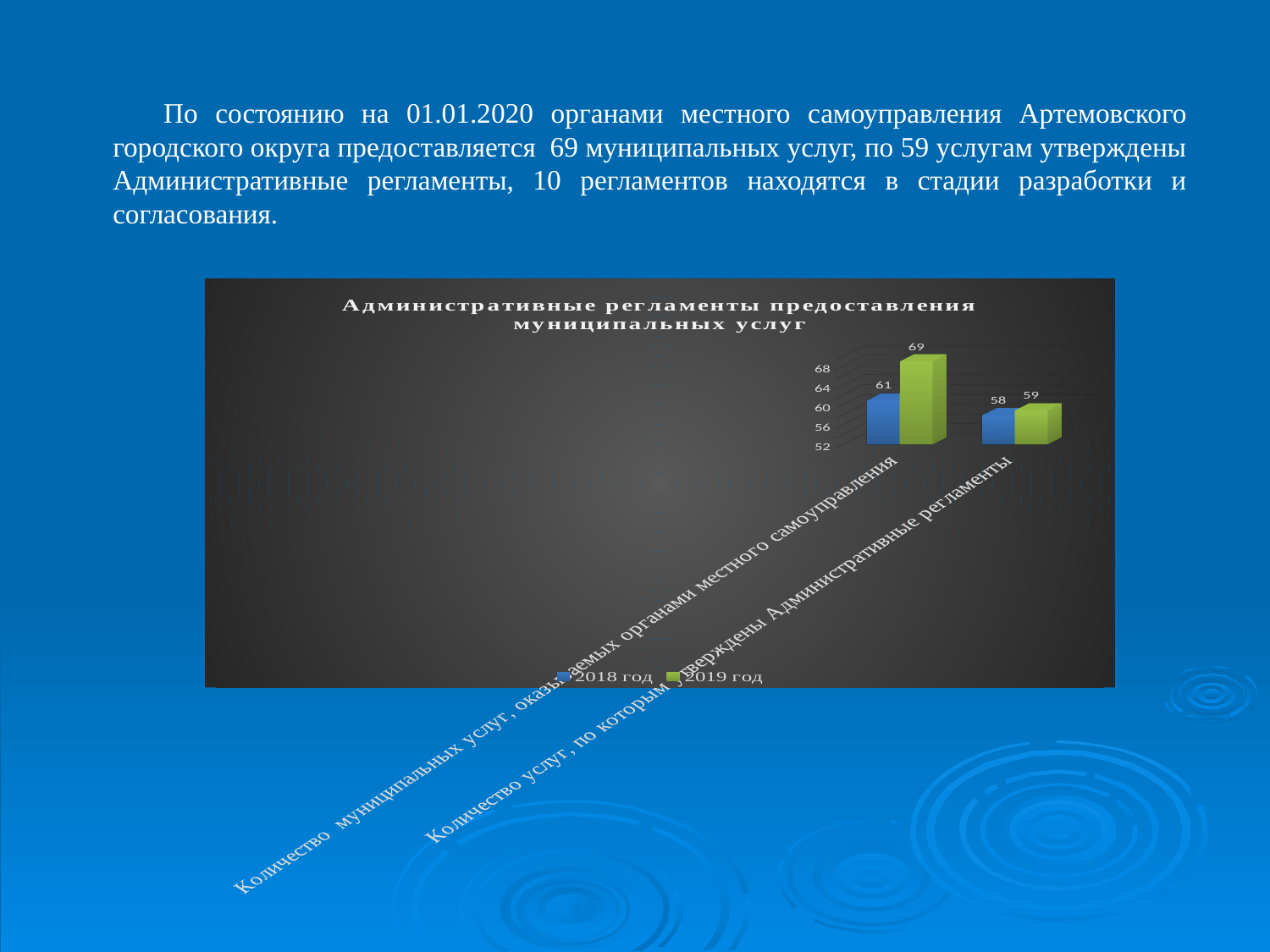
Which is larger for 'Количество муниципальных услуг, оказываемых органами местного самоуправления': the 2018 год value or the 2019 год value? 2019 год What is the difference between the 2019 год and 2018 год values for 'Количество муниципальных услуг, оказываемых органами местного самоуправления'? 8 Which bar has the highest value in the chart? 2019 год, Количество муниципальных услуг, оказываемых органами местного самоуправления (69) What is the value for 2019 год in the category 'Количество услуг, по которым утверждены Административные регламенты'? 59 Which series are listed in the legend? 2018 год, 2019 год What is the value for 2019 год in the category 'Количество муниципальных услуг, оказываемых органами местного самоуправления'? 69 How many series does the legend list? 2 How many categories are shown on the x axis? 2 What type of chart is shown on the slide? bar chart What is the value for 2018 год in the category 'Количество муниципальных услуг, оказываемых органами местного самоуправления'? 61 What is the title of the chart? Административные регламенты предоставления муниципальных услуг What is the value for 2018 год in the category 'Количество услуг, по которым утверждены Административные регламенты'? 58